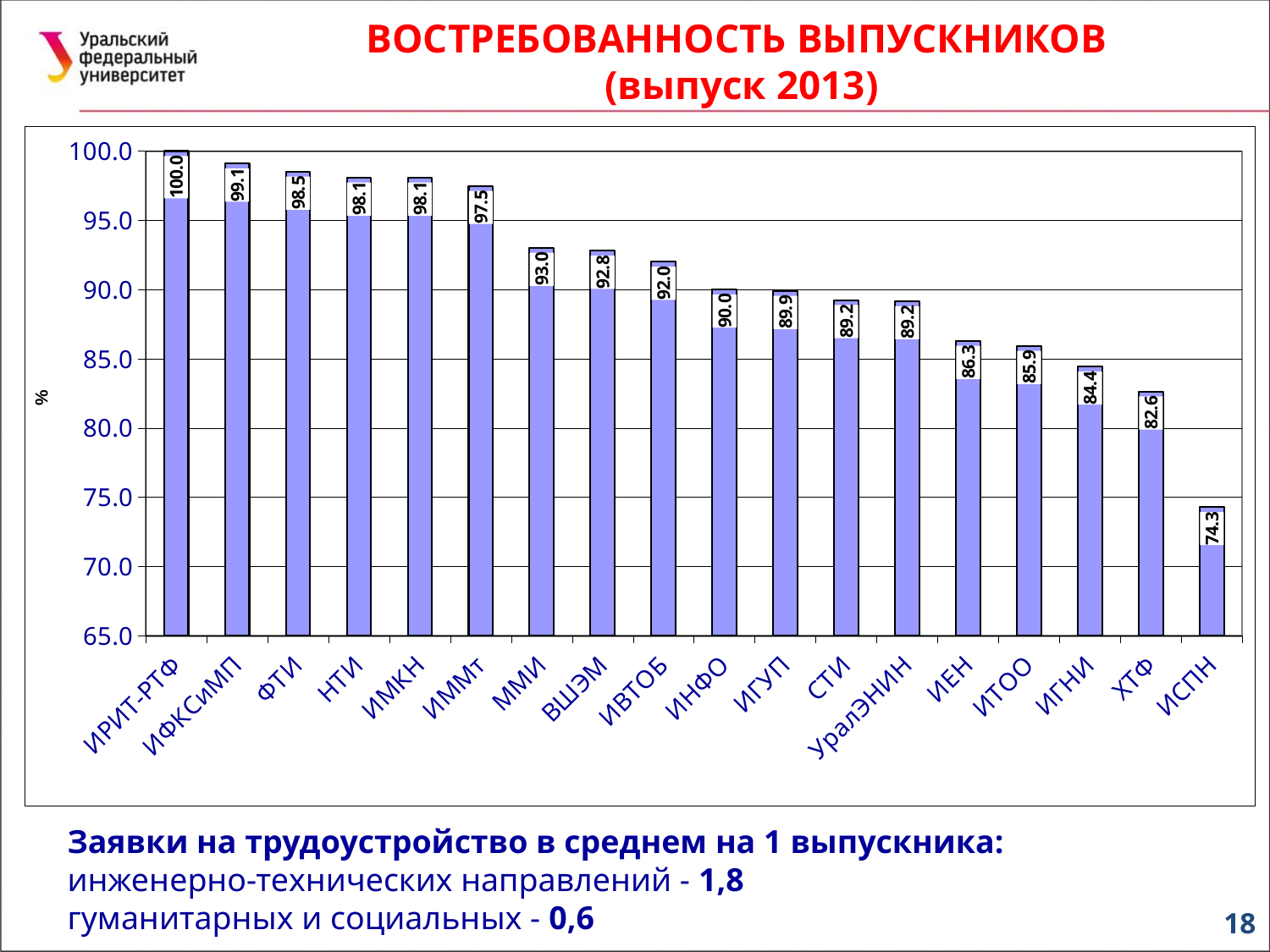
Do the values rise or fall from left to right along the x axis? Fall Which category has the lowest value? ИСПН What value is shown for ИРИТ-РТФ? 100.0 How many categories are shown on the x axis? 18 Which category has the highest value? ИРИТ-РТФ What value is shown for ВШЭМ? 92.8 What is the difference between the values for ММИ and ИЕН? 6.7 What value is shown for ИСПН? 74.3 What value is shown for УралЭНИН? 89.2 What kind of chart is shown on the slide? Bar chart What is the difference between the values for ИРИТ-РТФ and ИСПН? 25.7 Which is larger, the value for ХТФ or the value for ИГНИ? ИГНИ